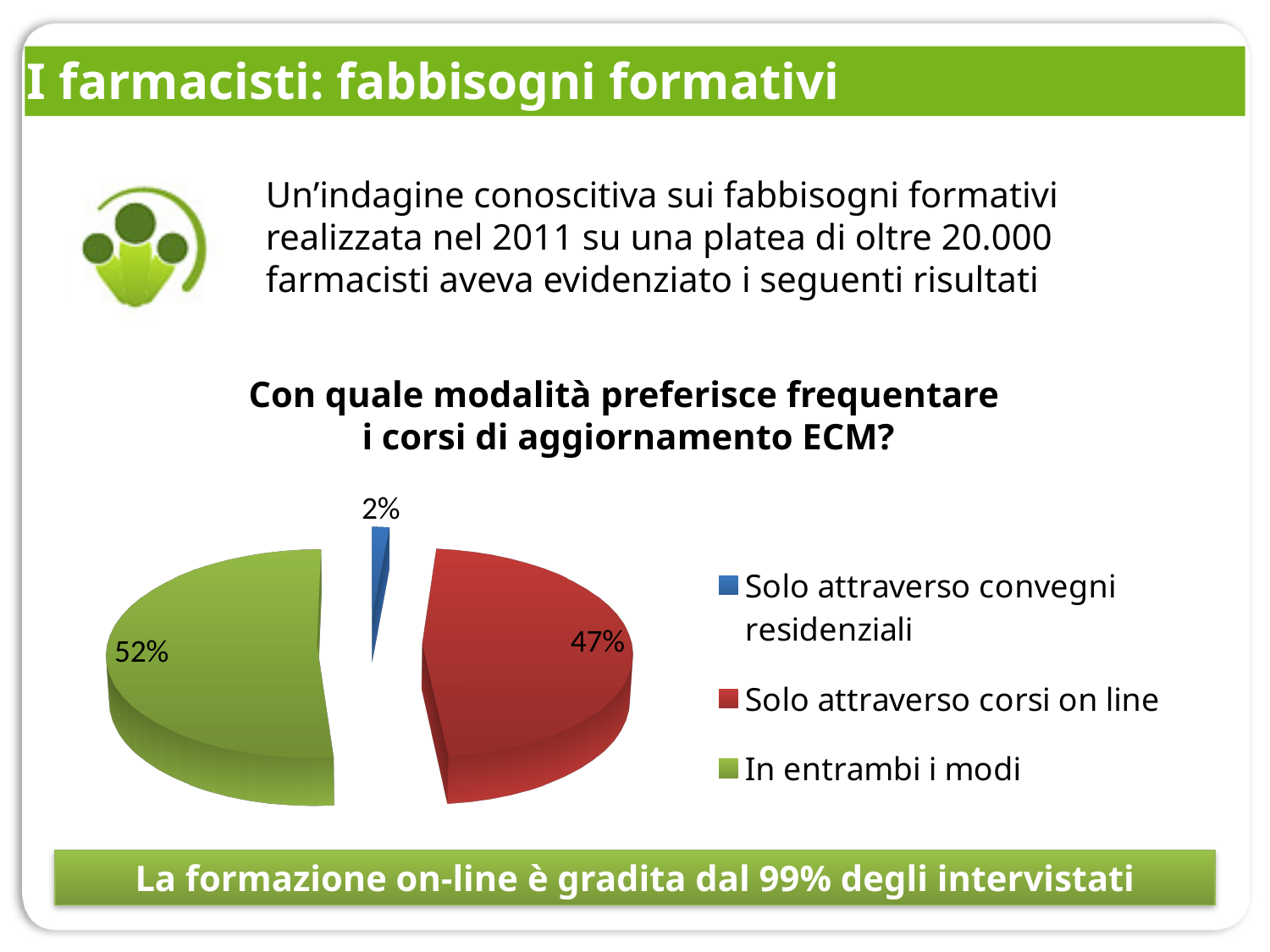
What percentage of respondents prefer 'Solo attraverso corsi on line'? 47% How many entries does the legend list? 3 What is the difference in percentage points between 'In entrambi i modi' and 'Solo attraverso corsi on line'? 5 Which category has the largest share of the pie? In entrambi i modi What percentage of respondents prefer 'Solo attraverso convegni residenziali'? 2% How many categories does the pie chart show? 3 What colour is the slice for 'Solo attraverso corsi on line'? red What kind of chart is shown on the slide? pie chart Which is larger: the share for 'Solo attraverso corsi on line' or the share for 'Solo attraverso convegni residenziali'? Solo attraverso corsi on line What is the title of the pie chart? Con quale modalità preferisce frequentare i corsi di aggiornamento ECM? Which category has the smallest share of the pie? Solo attraverso convegni residenziali What percentage of respondents prefer 'In entrambi i modi'? 52%